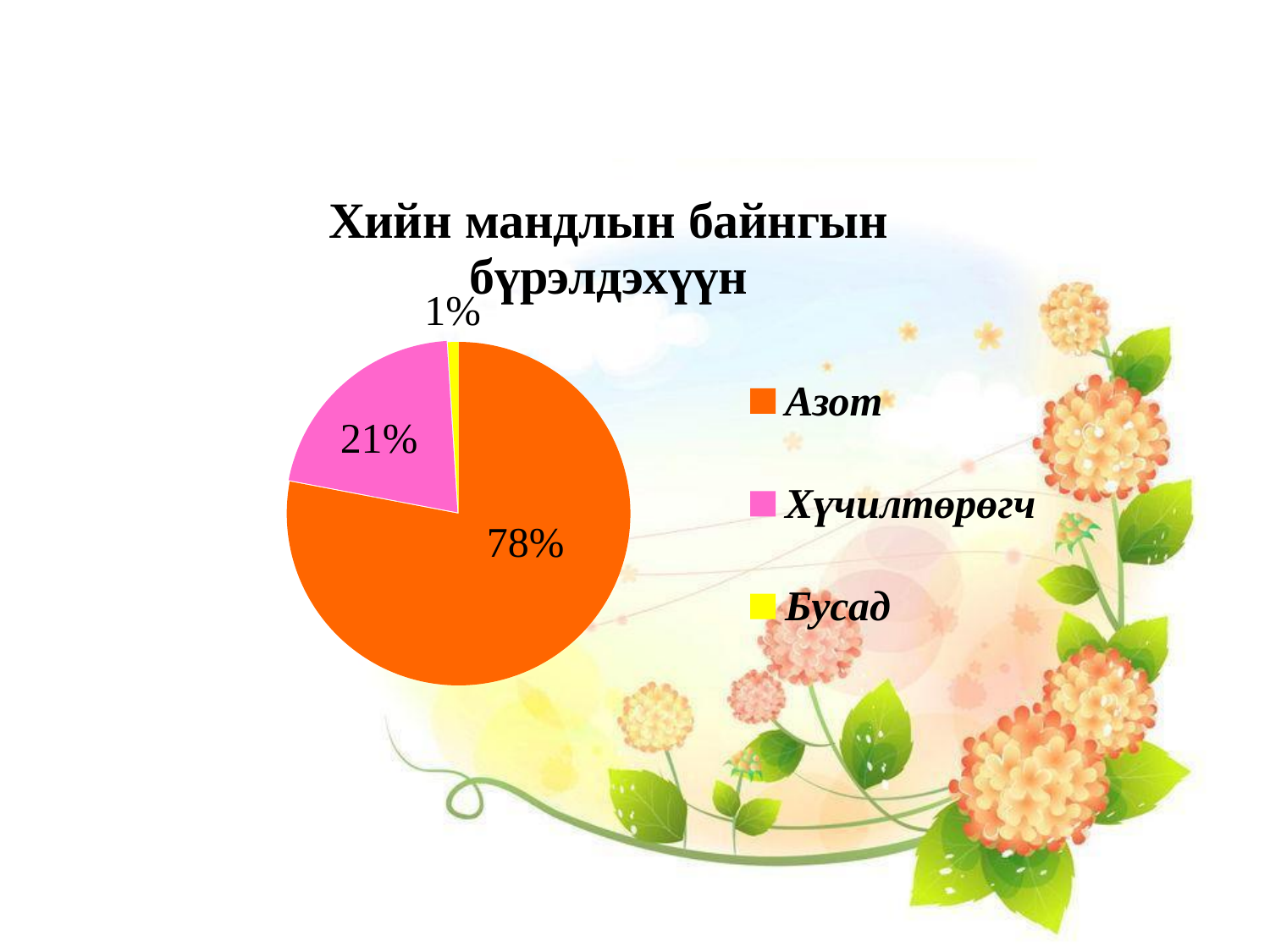
What share of the pie does Хүчилтөрөгч take? 21% What is the difference between the shares of Азот and Хүчилтөрөгч? 57% What colour is the slice for Хүчилтөрөгч? pink Which category has the smallest slice of the pie? Бусад Which category has the largest slice of the pie? Азот Which is larger, the share of Хүчилтөрөгч or the share of Бусад? Хүчилтөрөгч What kind of chart is shown on the slide? pie chart What share of the pie does Бусад take? 1% How many entries does the legend list? 3 What is the title of the chart? Хийн мандлын байнгын бүрэлдэхүүн What share of the pie does Азот take? 78% How many slices does the pie chart have? 3